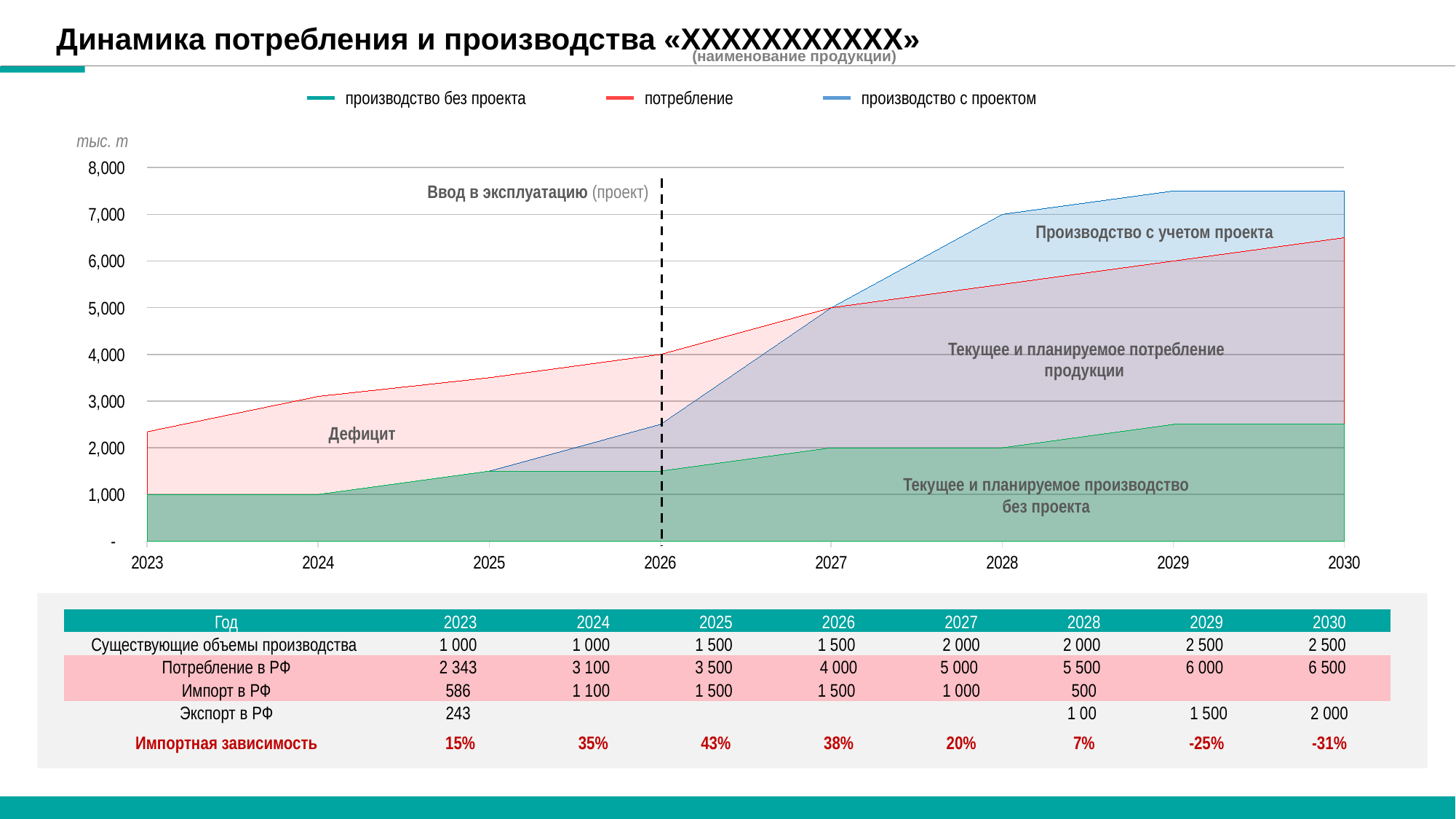
What is the difference between потребление and производство без проекта in 2030? 4 000 Is the value for производство с проектом in 2024 greater or less than 2,000? less In 2029, which is larger: производство с проектом or потребление? производство с проектом What kind of chart is shown on the slide? area chart At which year is the dashed vertical line labelled «Ввод в эксплуатацию (проект)» placed? 2026 Does потребление rise or fall from 2023 to 2030? rise What is the value of потребление in 2026? 4 000 What is the value of производство без проекта in 2030? 2 500 In which year is потребление highest? 2030 Is the value for производство с проектом in 2028 greater or less than 6,000? greater How many years are shown along the x axis of the chart? 8 How many series does the chart legend list? 3